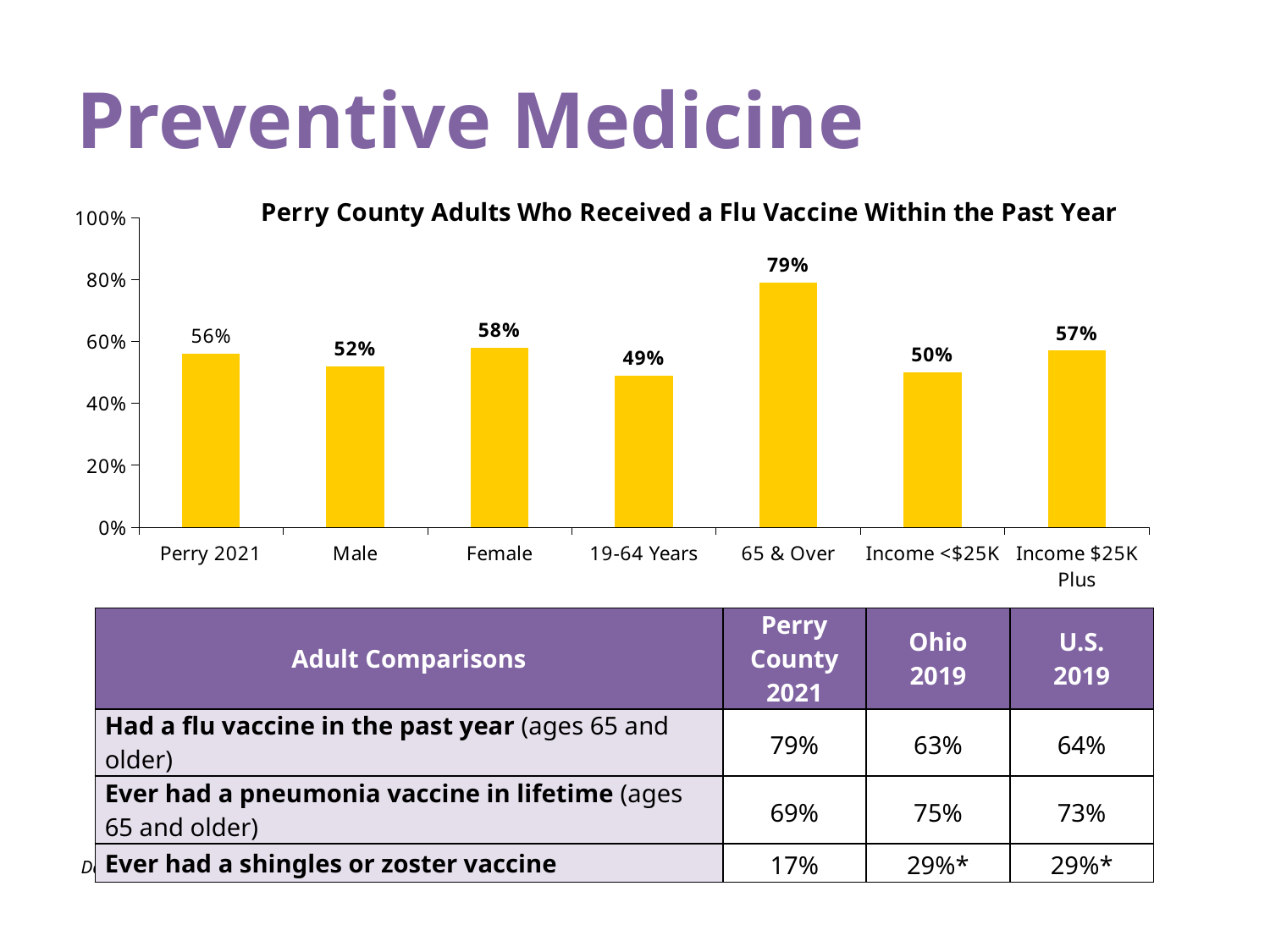
What percentage of Female adults received a flu vaccine within the past year? 58% What is the title of the chart? Perry County Adults Who Received a Flu Vaccine Within the Past Year Which is larger, the value for Income $25K Plus or the value for Income <$25K? Income $25K Plus How many categories are shown on the x axis of the chart? 7 Which category has the highest value in the chart? 65 & Over What is the value for Income <$25K? 50% What is the difference between the Female and Male values? 6% What kind of chart is shown on the slide? Bar chart What is the value for Perry 2021 in the chart? 56% Which category has the lowest value in the chart? 19-64 Years What is the difference between the values for 65 & Over and 19-64 Years? 30% What is the value for the 65 & Over category? 79%